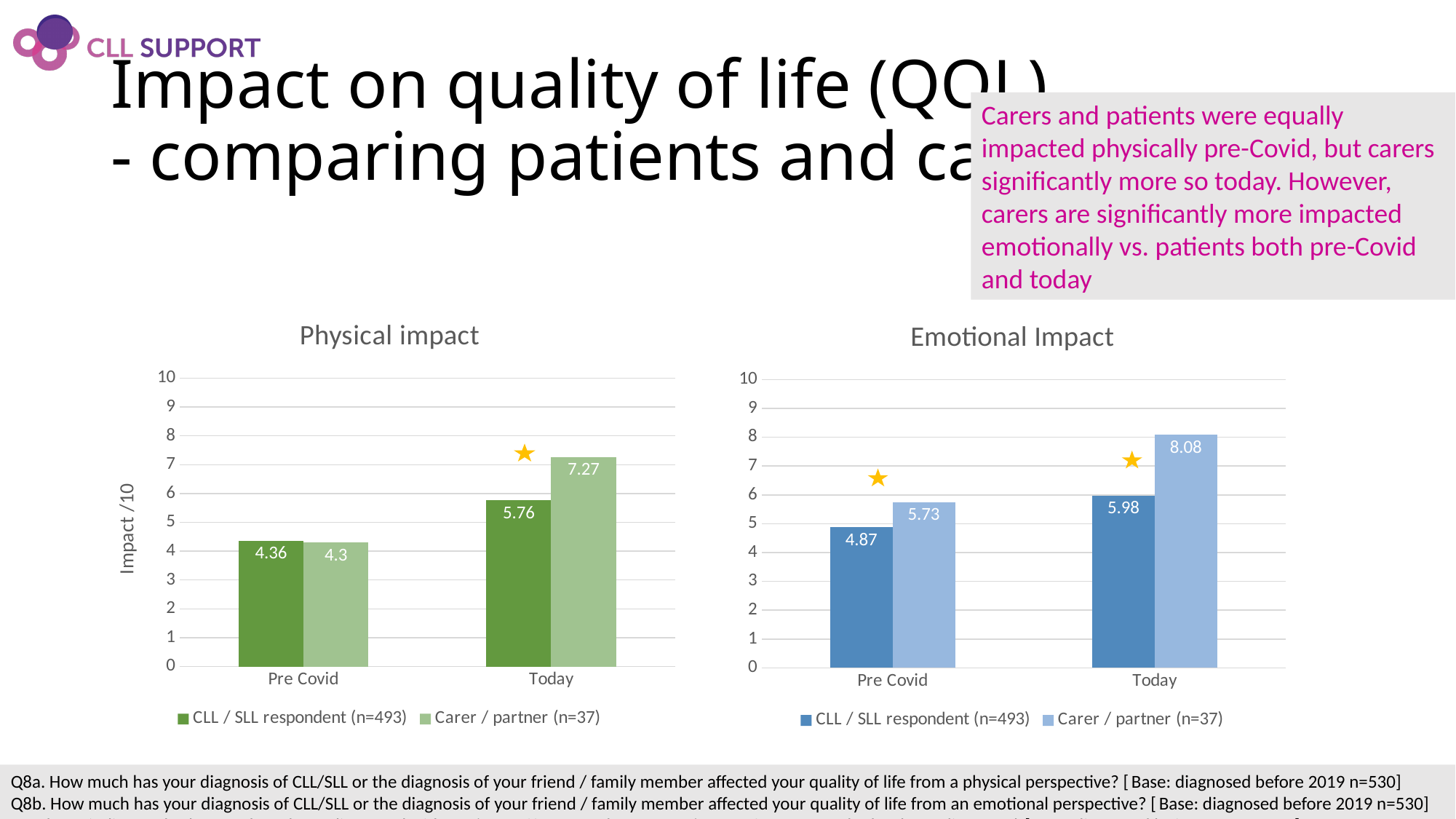
In the Emotional Impact chart, what is the value for CLL / SLL respondent (n=493) for Today? 5.98 In the Emotional Impact chart, which bar has the highest value? Carer / partner (n=37), Today In the Emotional Impact chart, which is larger for Pre Covid: CLL / SLL respondent (n=493) or Carer / partner (n=37)? Carer / partner (n=37) In the Physical impact chart, what is the difference between the Carer / partner (n=37) and CLL / SLL respondent (n=493) values for Today? 1.51 In the Emotional Impact chart, what is the difference between the Carer / partner (n=37) values for Today and Pre Covid? 2.35 In the Physical impact chart, do the CLL / SLL respondent (n=493) values rise or fall from Pre Covid to Today? Rise How many series does the legend of the Physical impact chart list? 2 What kind of chart is the Emotional Impact chart? Bar chart In the Physical impact chart, which bar has the lowest value? Carer / partner (n=37), Pre Covid In the Emotional Impact chart, what is the value for Carer / partner (n=37) for Pre Covid? 5.73 In the Physical impact chart, what is the value for CLL / SLL respondent (n=493) for Pre Covid? 4.36 In the Physical impact chart, what is the value for Carer / partner (n=37) for Today? 7.27